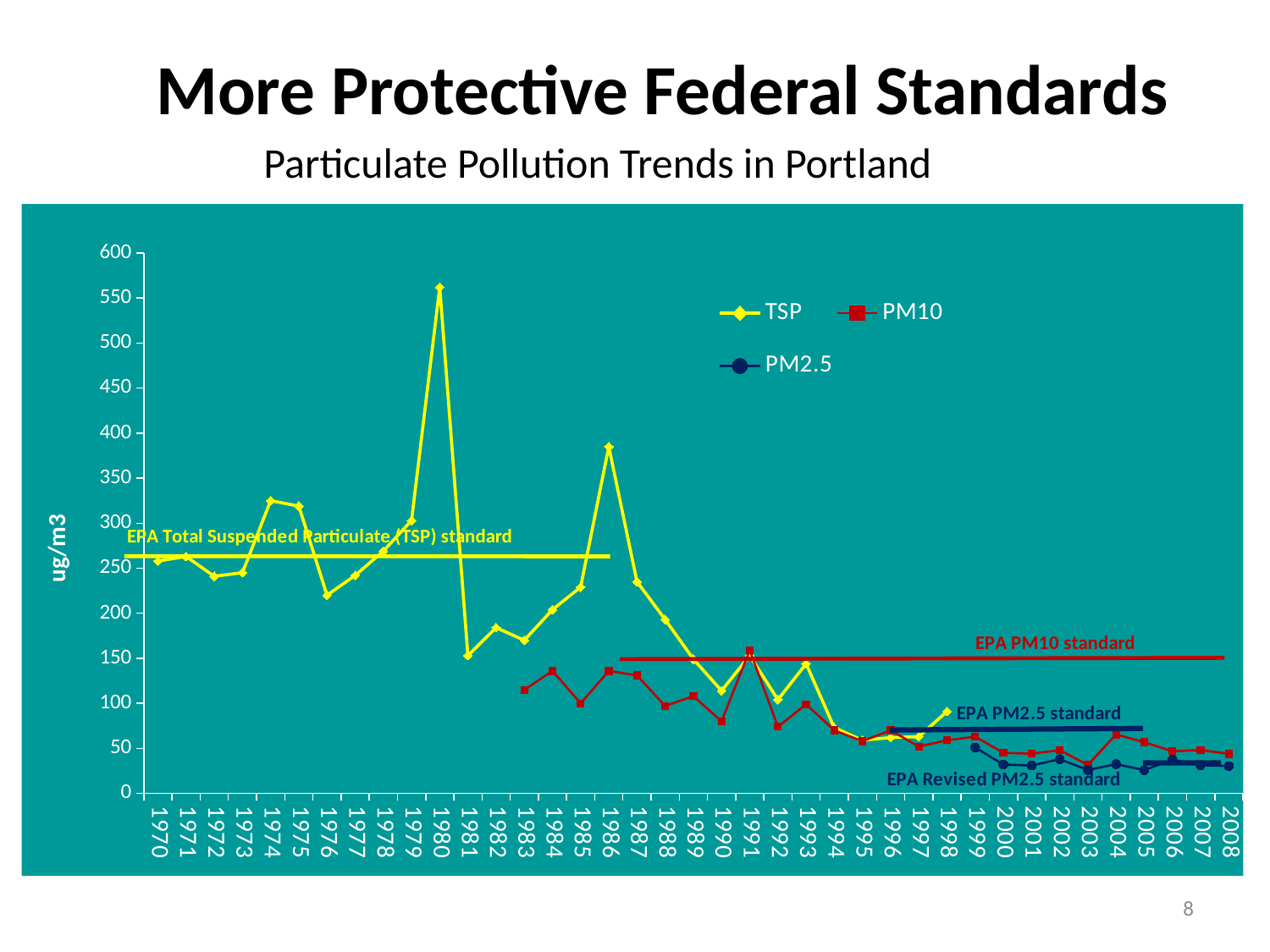
Does the TSP series generally rise or fall from 1970 to 1998? fall In which year does the TSP series reach its highest value? 1980 Is the PM10 value for 1990 greater or less than 100? less How many years are shown along the x axis? 39 Is the TSP value for 1980 greater or less than 500? greater In which year does the PM10 series reach its highest value? 1991 What is the label on the y axis of the chart? ug/m3 What kind of chart is shown on the slide? line chart Which is larger, the TSP value for 1980 or the TSP value for 1986? 1980 How many series does the legend list? 3 Is the PM2.5 value for 2000 greater or less than 50? less